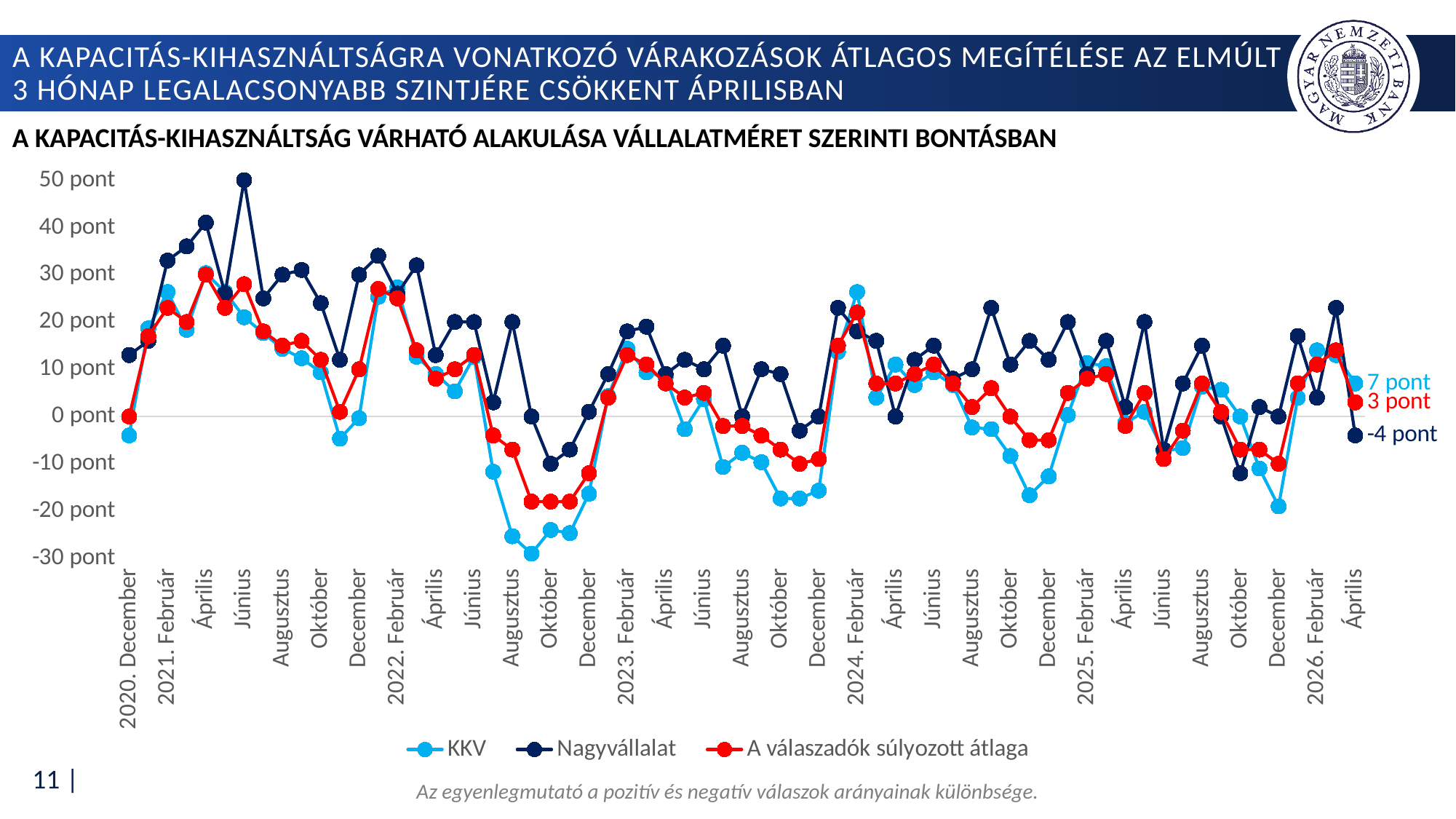
How many series does the legend list? 3 At the last point (2026 Április), which is larger: the KKV value or the Nagyvállalat value? KKV Which series reaches the lowest value anywhere on the chart? KKV What is the value of the KKV series at the last point (2026 Április)? 7 pont What is the value of the Nagyvállalat series at the last point (2026 Április)? -4 pont Does the Nagyvállalat series rise or fall between 2026 Február and 2026 Április? fall Is the value for Nagyvállalat in 2021 Június greater or less than 40 pont? greater What is the value of 'A válaszadók súlyozott átlaga' at the last point (2026 Április)? 3 pont What kind of chart is shown on the slide? line chart Which series reaches the highest value anywhere on the chart? Nagyvállalat At the last point (2026 Április), what is the difference between the KKV value and the Nagyvállalat value? 11 pont Is the value for KKV in 2022 Október greater or less than -20 pont? less